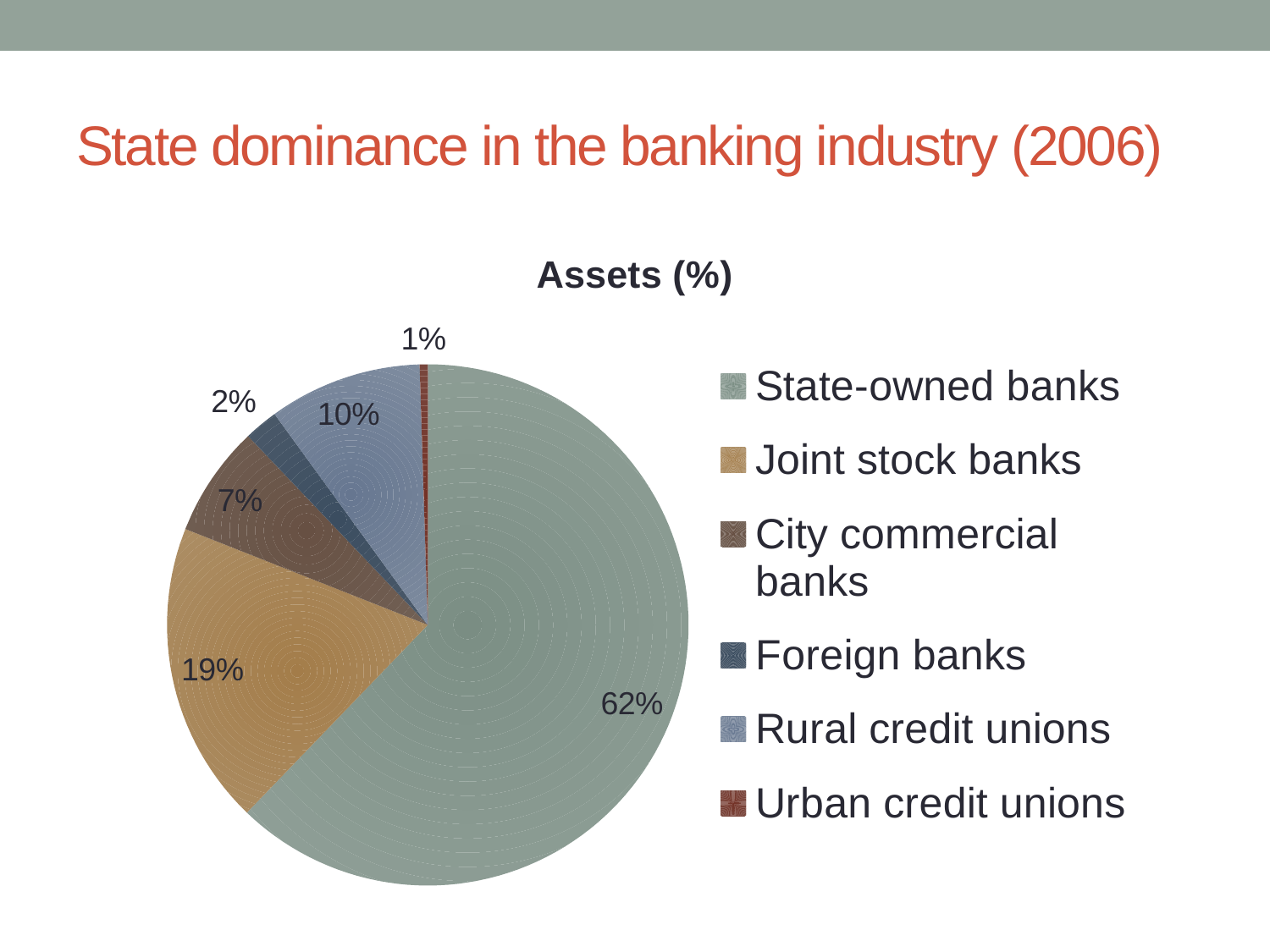
Which holds a larger share of assets, Rural credit unions or City commercial banks? Rural credit unions What kind of chart is shown on the slide? Pie chart What is the title of the chart? Assets (%) Which category holds the smallest share of assets? Urban credit unions What share of assets do Joint stock banks hold? 19% What share of assets do State-owned banks hold? 62% Which category holds the largest share of assets? State-owned banks What share of assets do City commercial banks hold? 7% What is the difference in asset share between State-owned banks and Joint stock banks? 43% How many categories are shown in the pie chart? 6 What share of assets do Rural credit unions hold? 10% What share of assets do Urban credit unions hold? 1%